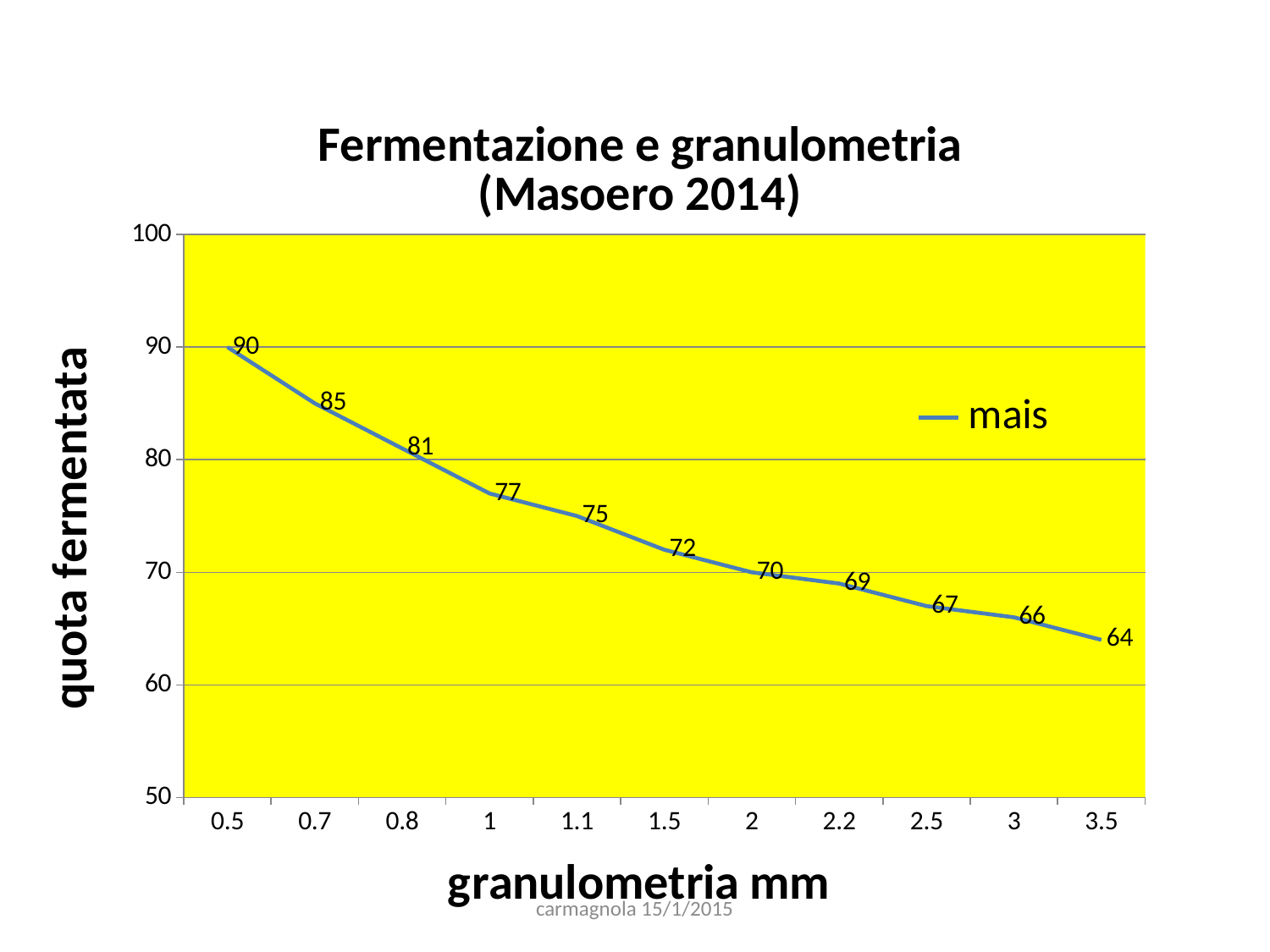
Is the quota fermentata at granulometria 2.2 mm greater or less than 70? less Does the quota fermentata rise or fall as granulometria increases? fall What is the quota fermentata value for granulometria 0.5 mm? 90 How many series does the legend list? 1 Which has a higher quota fermentata: granulometria 1 mm or 2 mm? 1 mm What is the difference between the quota fermentata at 0.5 mm and at 3.5 mm? 26 What is the quota fermentata value for granulometria 1.5 mm? 72 How many granulometria points are plotted on the chart? 11 At which granulometria is the quota fermentata lowest? 3.5 What kind of chart is shown on the slide? line chart At which granulometria is the quota fermentata highest? 0.5 What is the quota fermentata value for granulometria 3.5 mm? 64